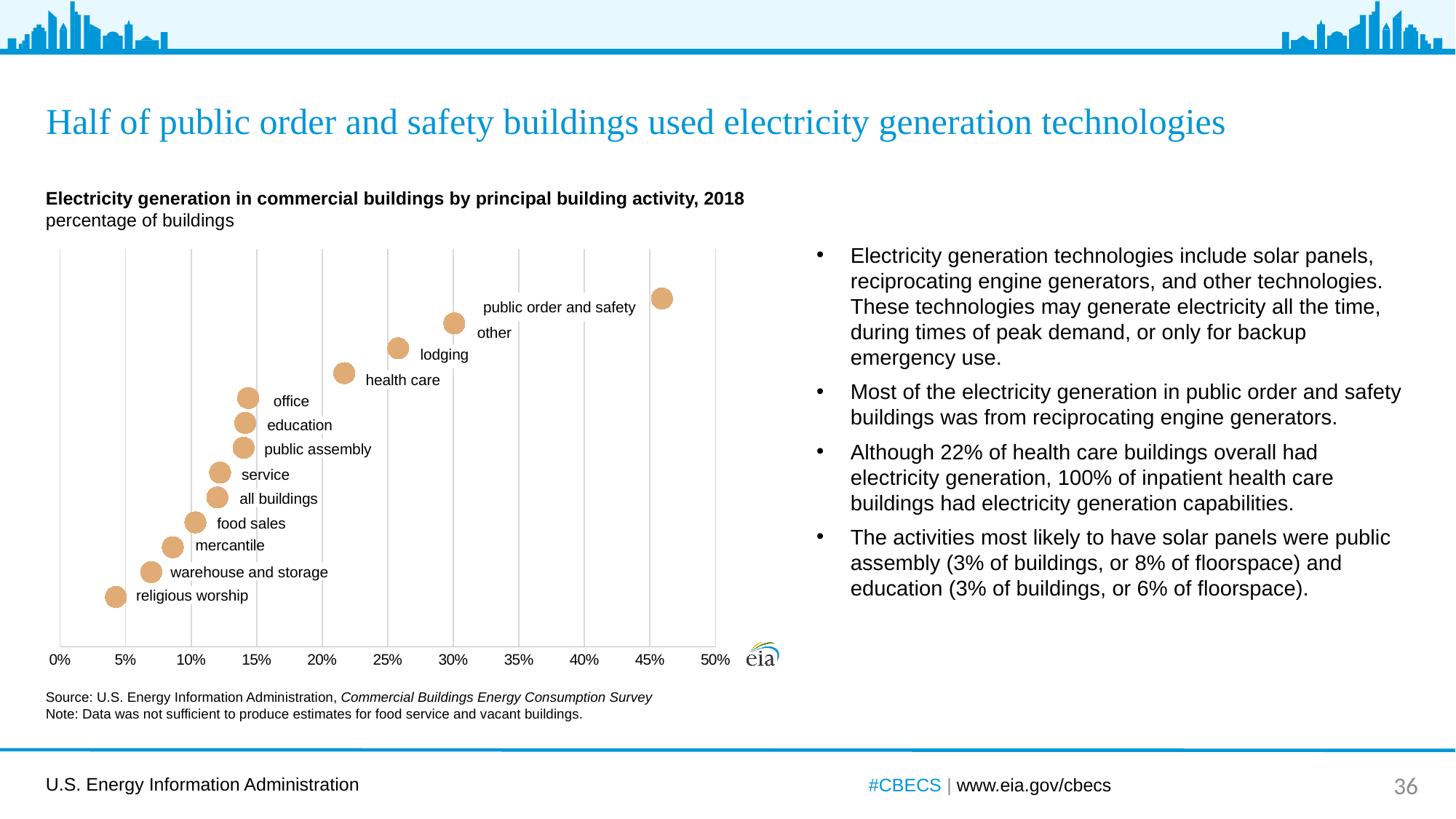
Is the value for other greater or less than 25%? greater Is the value for lodging greater or less than 30%? less Which building activity has the lowest percentage of buildings with electricity generation? religious worship Which has a higher value, lodging or health care? lodging Is the value for warehouse and storage greater or less than 10%? less What kind of chart is shown on the slide? scatter (dot) chart What is the title of the chart? Electricity generation in commercial buildings by principal building activity, 2018 How many building activities are plotted on the chart? 13 Which has a lower value, religious worship or mercantile? religious worship Which building activity has the highest percentage of buildings with electricity generation? public order and safety